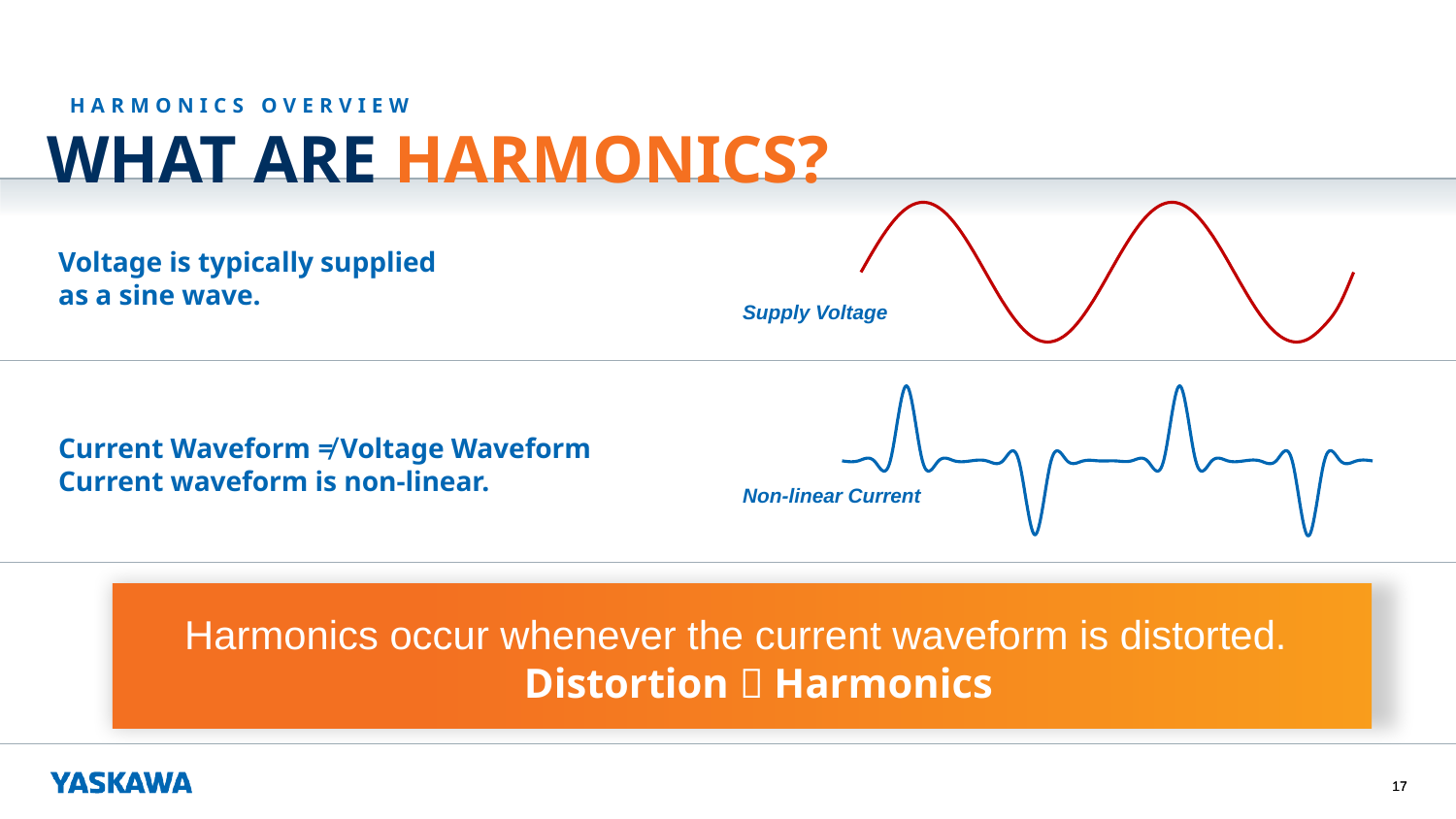
How many positive peaks does the "Supply Voltage" waveform show? 2 What colour is the line in the "Supply Voltage" chart? red How many large downward spikes does the "Non-linear Current" waveform show? 2 How many waveform charts are shown on the slide? 2 What kind of chart is the "Supply Voltage" graphic on the right of the slide? line chart Which of the two waveform charts on the slide is a smooth sine wave? Supply Voltage What colour is the line in the "Non-linear Current" chart? blue What kind of chart is the "Non-linear Current" graphic on the right of the slide? line chart